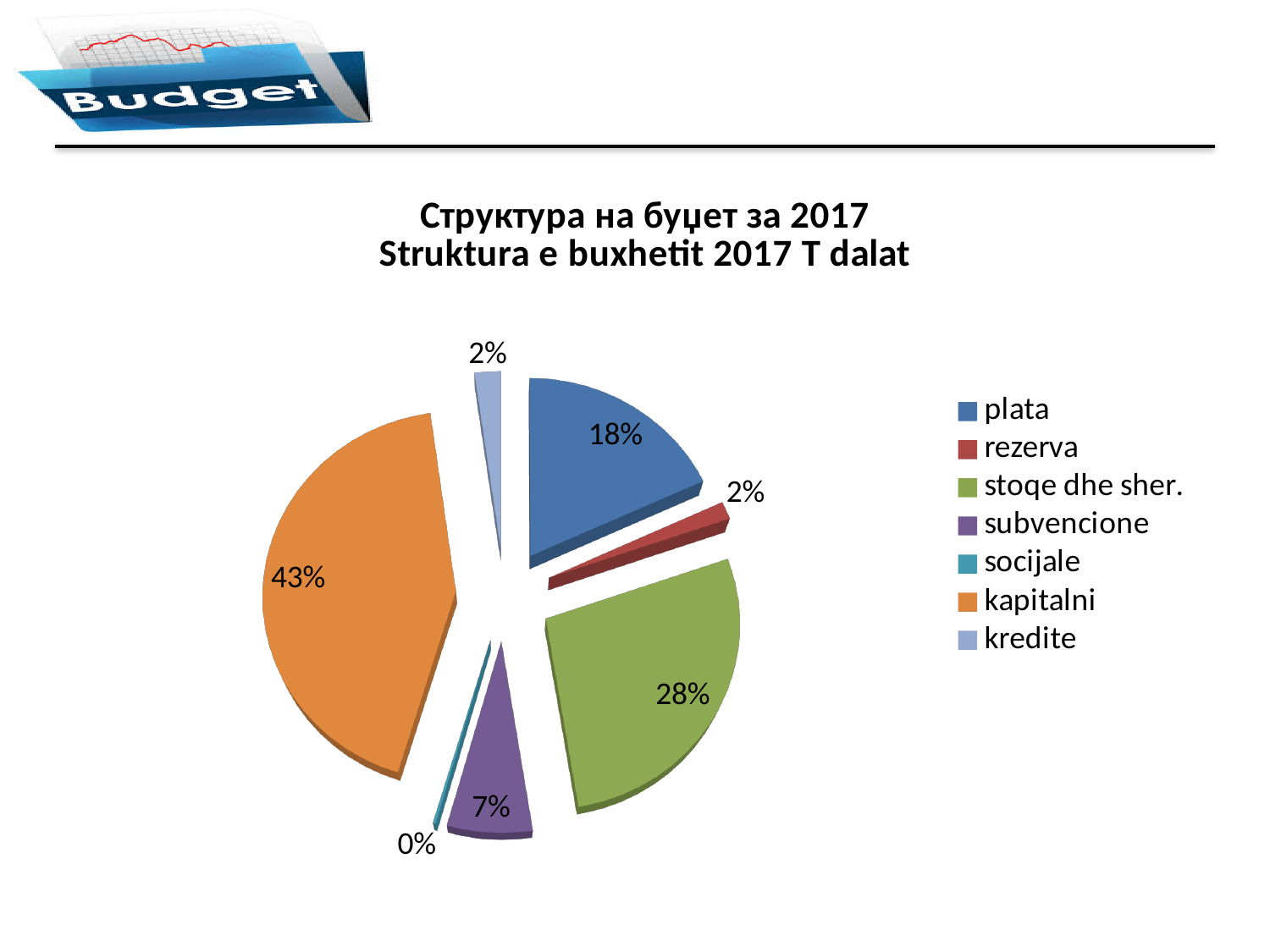
What colour is the slice for kapitalni? orange Which is larger, the share for plata or the share for subvencione? plata Which category has the largest share of the pie? kapitalni How many categories does the legend list? 7 Which category has the smallest share of the pie? socijale What percentage is shown for plata? 18% What percentage is shown for subvencione? 7% What percentage is shown for socijale? 0% What is the difference in percentage points between kapitalni and stoqe dhe sher.? 15 What kind of chart is shown on the slide? pie chart What share of the pie does kapitalni represent? 43% What percentage is shown for stoqe dhe sher.? 28%